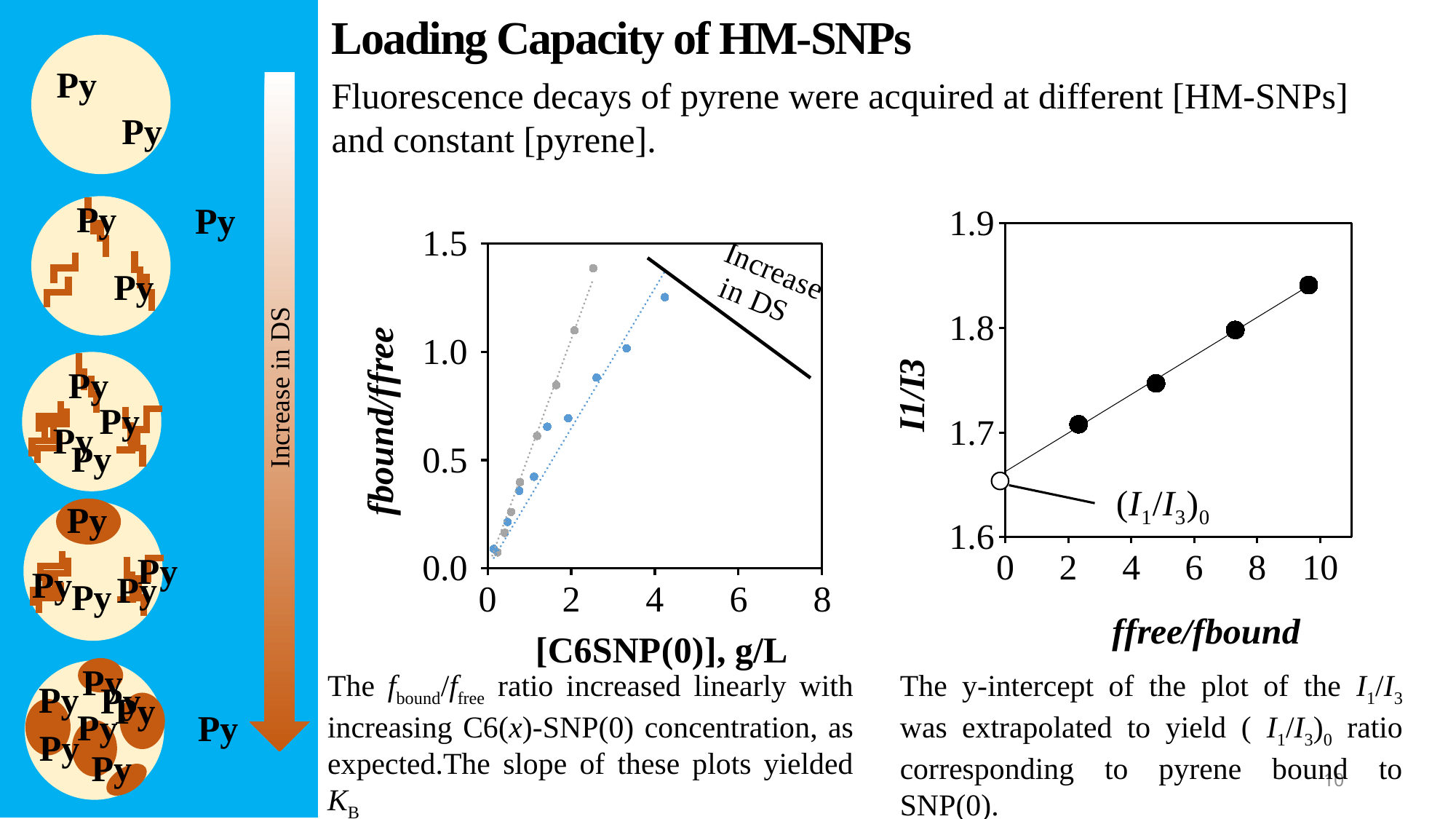
In the right chart, what is the label of the y axis? I1/I3 What kind of chart is the left chart, fbound/ffree versus [C6SNP(0)]? scatter plot In the right chart, does I1/I3 rise or fall as ffree/fbound increases? rise In the right chart, is the I1/I3 value of the rightmost filled point greater or less than 1.8? greater In the left chart, which series rises more steeply with [C6SNP(0)], the gray points or the blue points? gray points In the right chart, is the I1/I3 value of the open circle at ffree/fbound = 0 greater or less than 1.7? less In the left chart, what is the label of the x axis? [C6SNP(0)], g/L In the right chart, how many filled black data points are plotted? 4 In the left chart, do the fbound/ffree values rise or fall as [C6SNP(0)] increases? rise In the left chart, how many data series (sets of differently coloured points) are plotted? 2 What kind of chart is the right chart, I1/I3 versus ffree/fbound? scatter plot In the left chart, is the highest gray point's fbound/ffree value greater or less than 1.0? greater